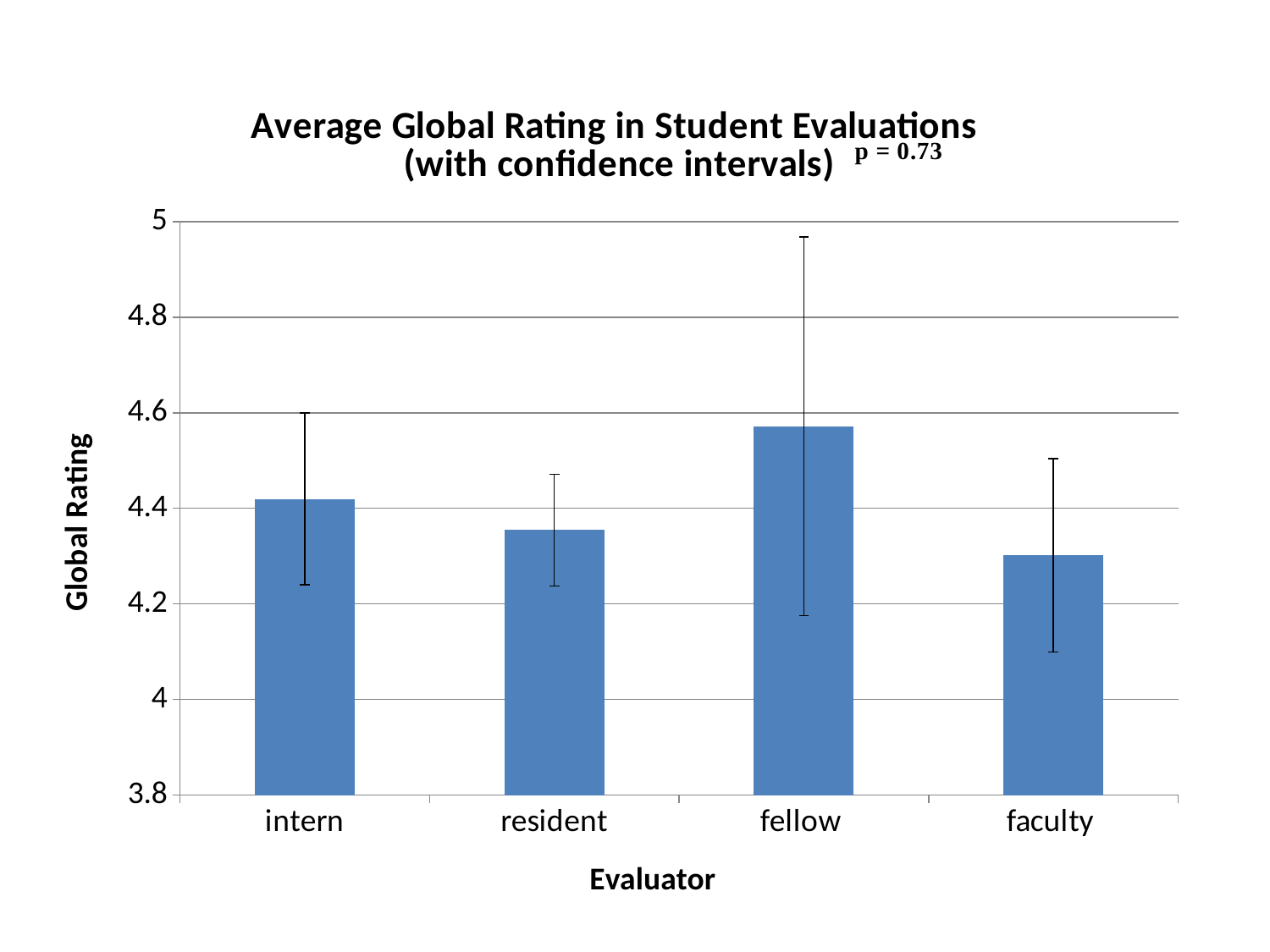
What p value is printed next to the chart title? p = 0.73 What is the title of the y axis? Global Rating Is the value for intern greater or less than 4.2? greater How many evaluator categories are shown on the x axis? 4 Which evaluator has the lowest average global rating? faculty Is the value for faculty greater or less than 4.2? greater Which evaluator has the highest average global rating? fellow Which has a higher average global rating, intern or resident? intern What kind of chart is shown on the slide? bar chart Is the value for resident greater or less than 4.4? less Which has a higher average global rating, fellow or faculty? fellow